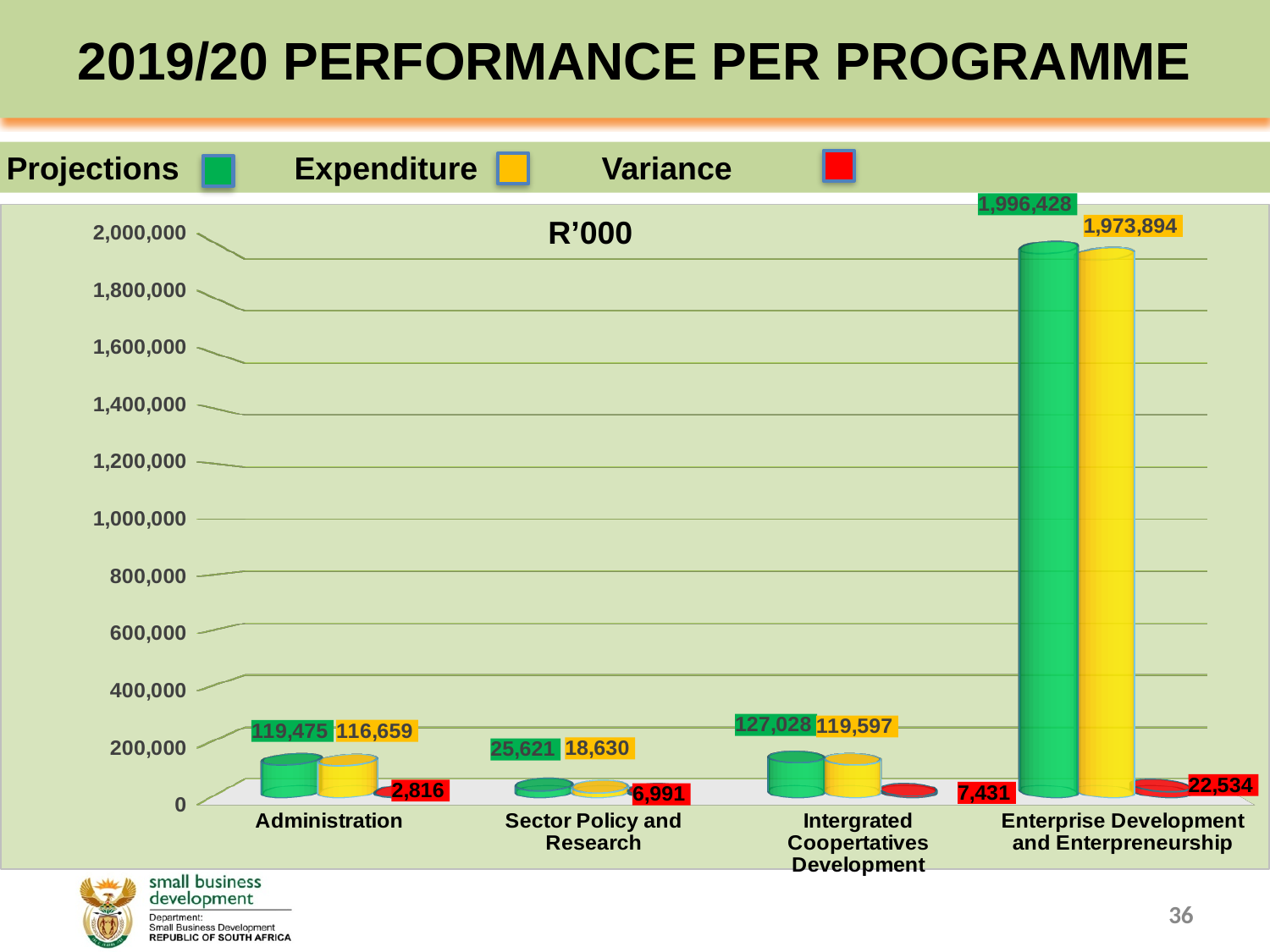
Which is larger, the Projections value for Administration or the Projections value for Intergrated Coopertatives Development? Intergrated Coopertatives Development Which programme has the highest Projections value? Enterprise Development and Enterpreneurship What kind of chart is shown on the slide? Bar chart What is the Projections value for Administration? 119,475 What is the Expenditure value for Sector Policy and Research? 18,630 Is the Expenditure value for Enterprise Development and Enterpreneurship greater or less than 1,800,000? greater Which programme has the lowest Expenditure value? Sector Policy and Research What is the Variance value for Enterprise Development and Enterpreneurship? 22,534 What is the Expenditure value for Intergrated Coopertatives Development? 119,597 How many series does the legend list? 3 How many programmes are shown on the x axis of the chart? 4 What is the difference between Projections and Expenditure for Enterprise Development and Enterpreneurship? 22,534